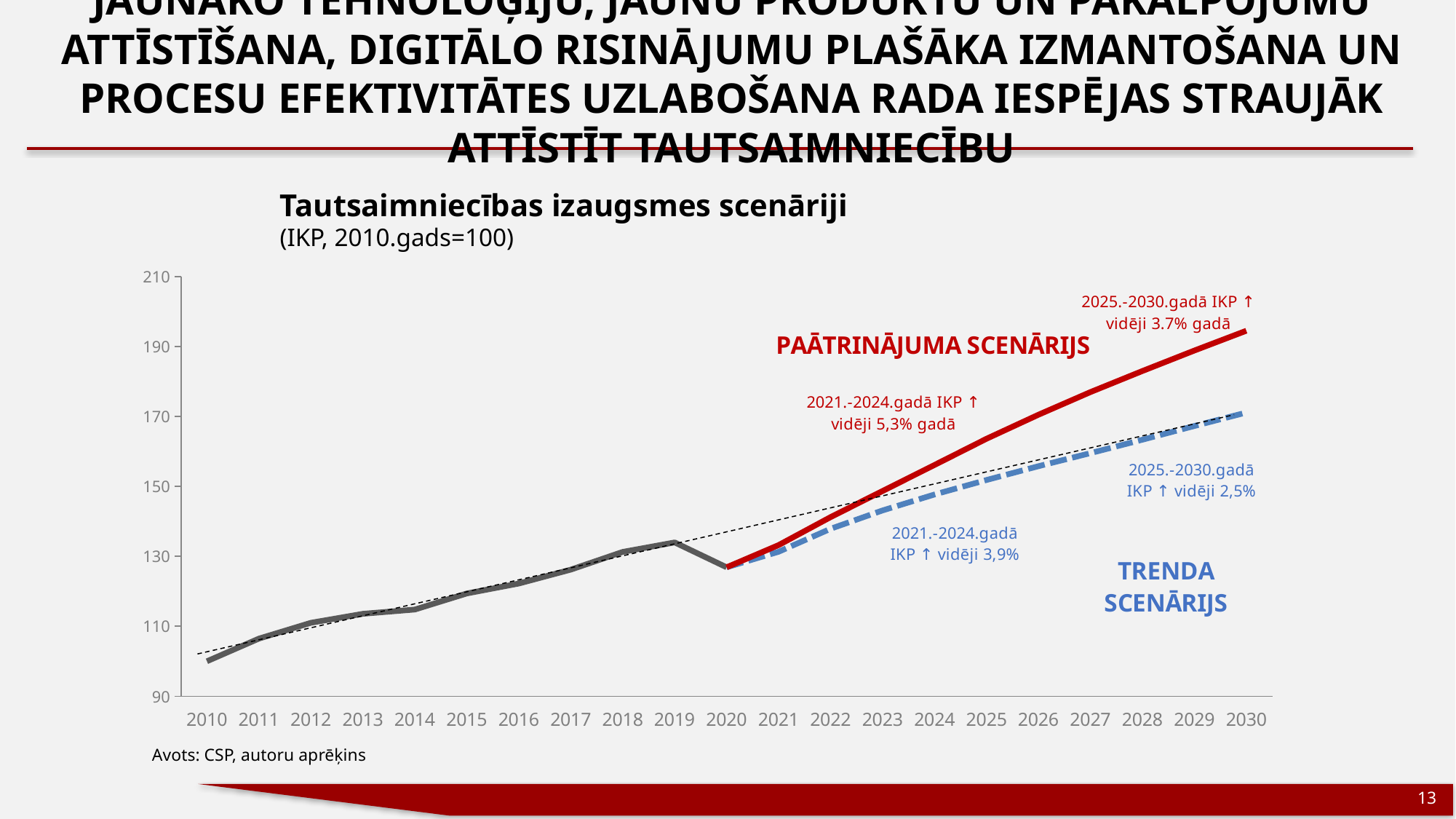
Which scenario reaches the higher value in 2030, PAĀTRINĀJUMA SCENĀRIJS or TRENDA SCENĀRIJS? PAĀTRINĀJUMA SCENĀRIJS Is the value of the PAĀTRINĀJUMA SCENĀRIJS line in 2030 greater or less than 190? greater Is the value for 2019 greater or less than 130? greater Does the PAĀTRINĀJUMA SCENĀRIJS line rise or fall from 2020 to 2030? rise What is the title of the chart? Tautsaimniecības izaugsmes scenāriji Is the value of the TRENDA SCENĀRIJS line in 2030 greater or less than 190? less According to the annotation, what is the average annual GDP growth in 2021-2024 under the PAĀTRINĀJUMA SCENĀRIJS? 5,3% How many years are labelled on the x axis of the chart? 21 According to the annotation, what is the average annual GDP growth in 2025-2030 under the TRENDA SCENĀRIJS? 2,5% What source is cited below the chart? CSP, autoru aprēķins What kind of chart is shown on the slide? line chart